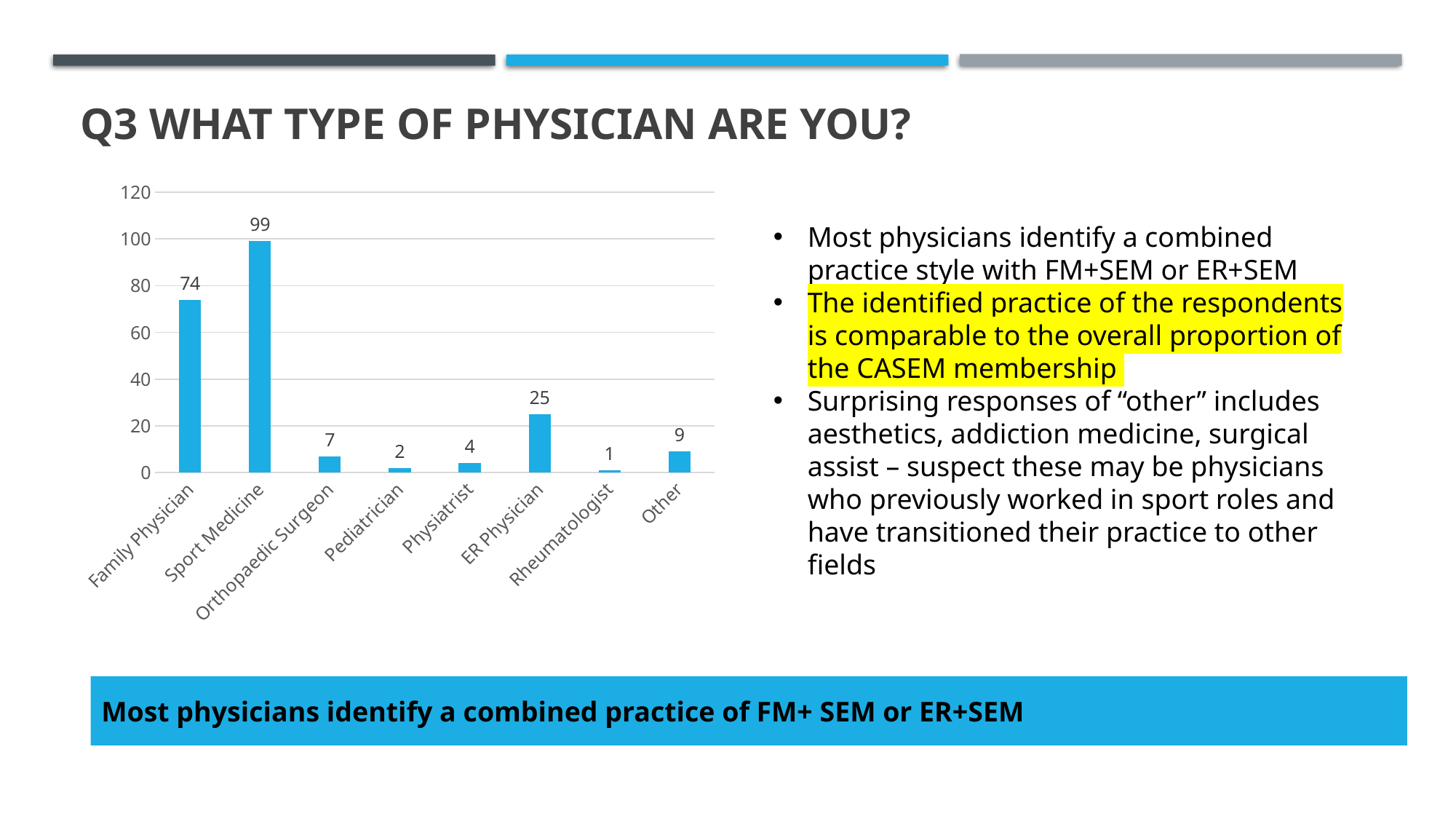
What kind of chart is shown on the slide? Bar chart What is the value for Family Physician? 74 What is the difference between the values for ER Physician and Other? 16 What is the value for Rheumatologist? 1 How many categories are shown on the x axis? 8 Which category has the highest value? Sport Medicine Is the value for Family Physician greater or less than 60? greater Which category has the lowest value? Rheumatologist Which is larger, the value for Orthopaedic Surgeon or the value for Other? Other What is the difference between the values for Sport Medicine and Family Physician? 25 What is the value for Sport Medicine? 99 What is the value for ER Physician? 25